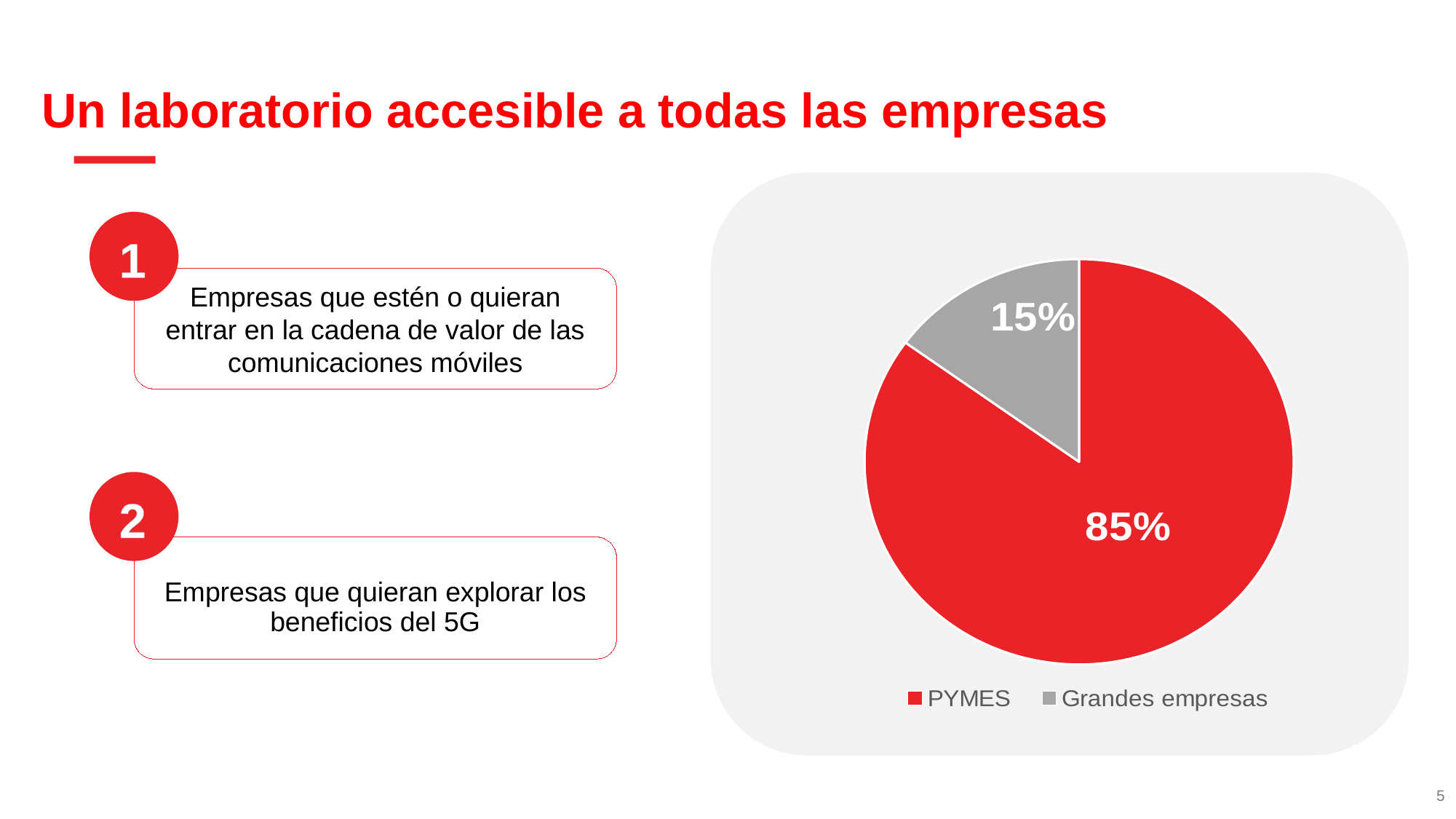
Which category has the largest slice of the pie? PYMES What is the difference in percentage points between PYMES and Grandes empresas? 70 What kind of chart is shown on the slide? Pie chart Which category has the smallest slice of the pie? Grandes empresas What colour is the PYMES slice? Red What share of the pie does PYMES represent? 85% Which is larger, the slice for PYMES or the slice for Grandes empresas? PYMES What share of the pie does Grandes empresas represent? 15% How many slices does the pie chart have? 2 How many entries does the legend list? 2 What colour is the Grandes empresas slice? Grey